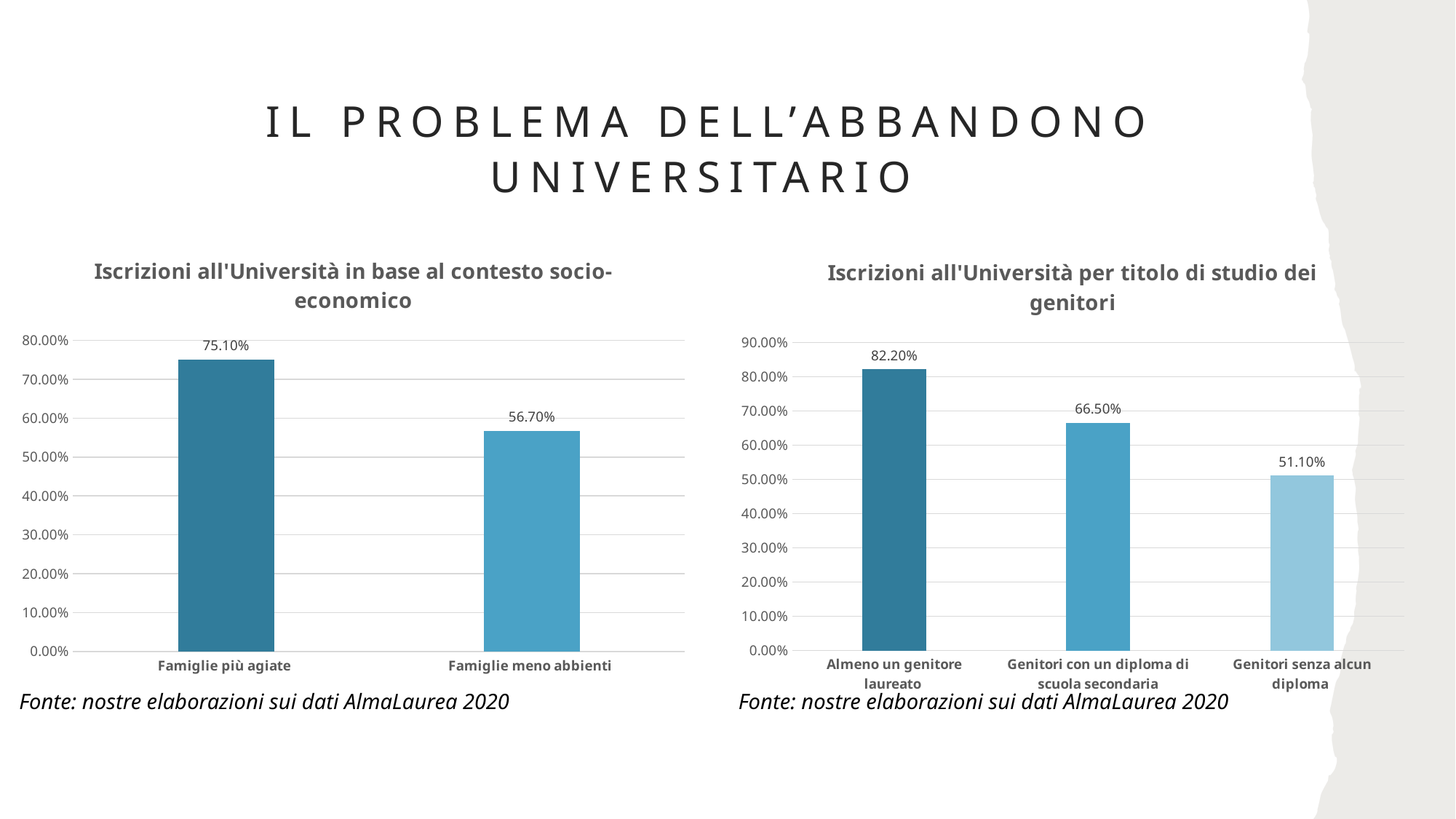
In the right chart (Iscrizioni all'Università per titolo di studio dei genitori), do the values rise or fall from left to right? Fall In the right chart (Iscrizioni all'Università per titolo di studio dei genitori), what is the value for Genitori con un diploma di scuola secondaria? 66.50% In the right chart (Iscrizioni all'Università per titolo di studio dei genitori), what is the difference between Almeno un genitore laureato and Genitori senza alcun diploma? 31.10% In the right chart (Iscrizioni all'Università per titolo di studio dei genitori), which category has the lowest value? Genitori senza alcun diploma In the left chart (Iscrizioni all'Università in base al contesto socio-economico), what is the value for Famiglie più agiate? 75.10% In the left chart (Iscrizioni all'Università in base al contesto socio-economico), what is the value for Famiglie meno abbienti? 56.70% In the left chart (Iscrizioni all'Università in base al contesto socio-economico), what is the difference between Famiglie più agiate and Famiglie meno abbienti? 18.40% In the right chart (Iscrizioni all'Università per titolo di studio dei genitori), what is the value for Genitori senza alcun diploma? 51.10% In the right chart (Iscrizioni all'Università per titolo di studio dei genitori), how many categories are shown? 3 In the right chart (Iscrizioni all'Università per titolo di studio dei genitori), what is the value for Almeno un genitore laureato? 82.20% In the left chart (Iscrizioni all'Università in base al contesto socio-economico), how many categories are shown? 2 In the left chart (Iscrizioni all'Università in base al contesto socio-economico), what kind of chart is it? Bar chart